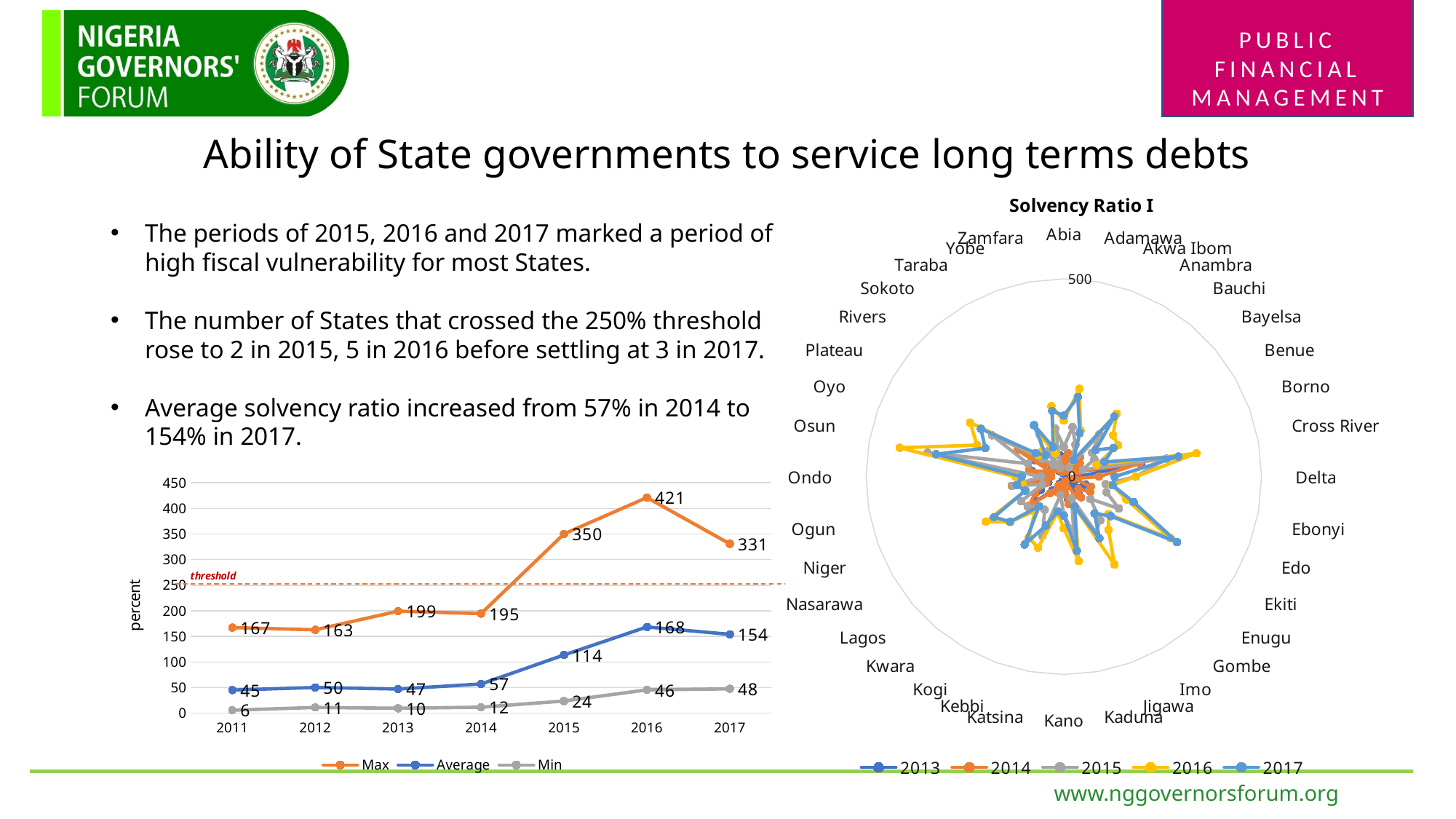
In the line chart on the left, what is the Average value for 2014? 57 In the line chart on the left, which year has the highest Max value? 2016 In the line chart on the left, what is the Min value for 2017? 48 In the line chart on the left, which year has the lowest Min value? 2011 In the line chart on the left, what is the Max value for 2016? 421 In the line chart on the left, is the Average value larger in 2016 or in 2017? 2016 In the line chart on the left, at what value is the dashed threshold line drawn? 250 In the line chart on the left, how many series does the legend list? 3 In the Solvency Ratio I chart, how many series does the legend list? 5 In the line chart on the left, what is the difference between the Max value in 2016 and the Max value in 2017? 90 In the line chart on the left, how many years are shown on the x axis? 7 What kind of chart is the chart on the left of the slide? Line chart